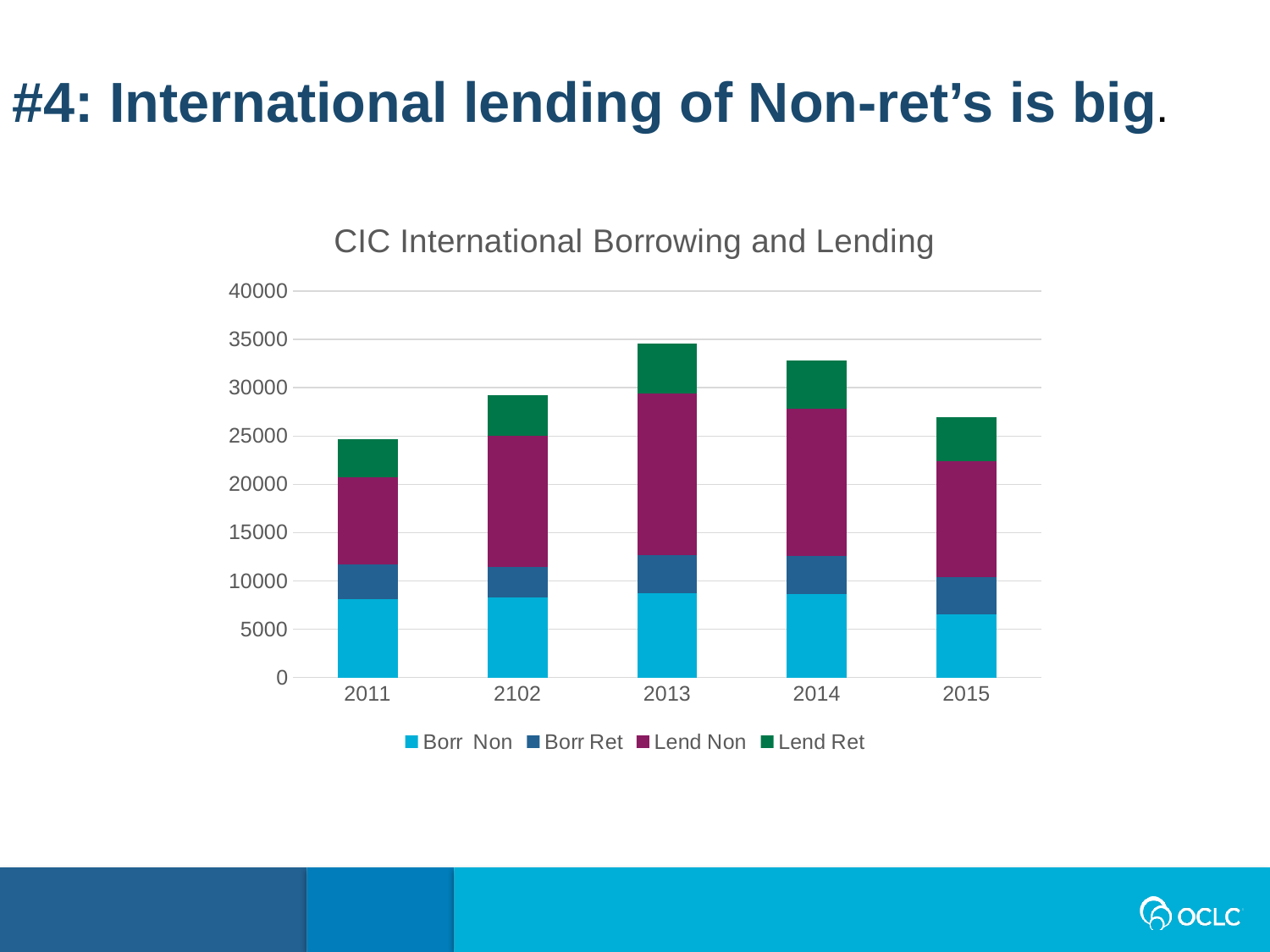
What is the title of the chart? CIC International Borrowing and Lending What kind of chart is shown on the slide? Stacked bar chart Is the total stacked value for 2014 greater or less than 30000? greater Is the total stacked value for 2013 greater or less than 30000? greater Which has the larger total stacked value, 2013 or 2015? 2013 Which series is listed first in the legend? Borr Non Which year has the tallest stacked bar? 2013 Is the total stacked value for 2015 greater or less than 30000? less Do the total stacked values rise or fall from 2011 to 2013? rise Which year has the shortest stacked bar? 2011 How many bars (years) are shown on the x axis? 5 How many series does the legend list? 4